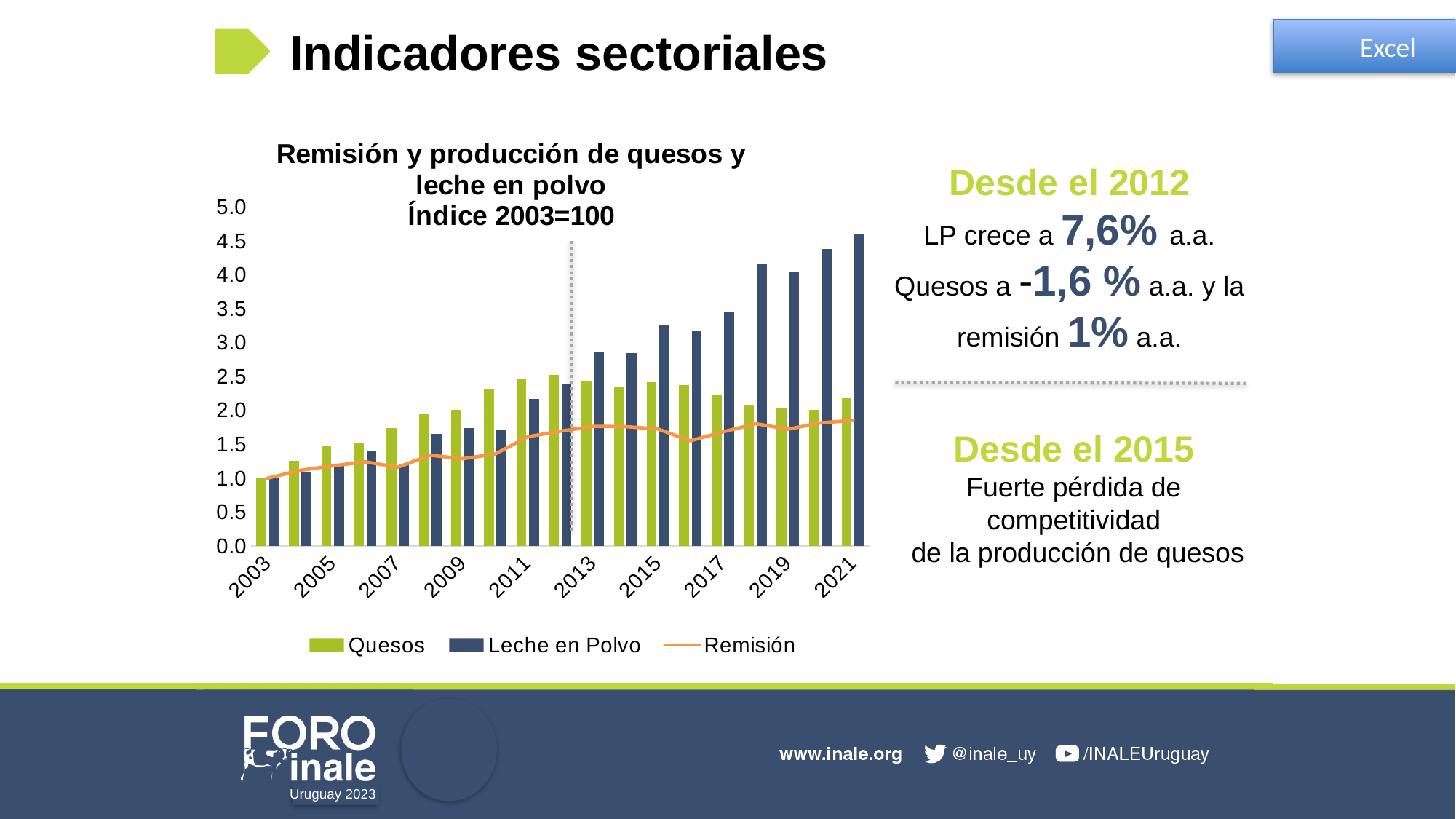
Is the value for Quesos in 2021 greater or less than 2.5? less In which year is the Leche en Polvo bar highest? 2021 Does the Leche en Polvo series generally rise or fall from 2003 to 2021? Rise What is the value of the Leche en Polvo series in 2003? 1.0 Is the value for Leche en Polvo in 2021 greater or less than 4.0? greater How many series does the chart legend list? 3 How many years are plotted along the x axis of the chart? 19 In 2021, which is larger: the Quesos bar or the Leche en Polvo bar? Leche en Polvo What kind of chart is shown on the slide? A bar chart combined with a line In which year is the Leche en Polvo bar lowest? 2003 Is the value for Remisión in 2021 greater or less than 1.5? greater Which series are listed in the chart legend? Quesos, Leche en Polvo, Remisión